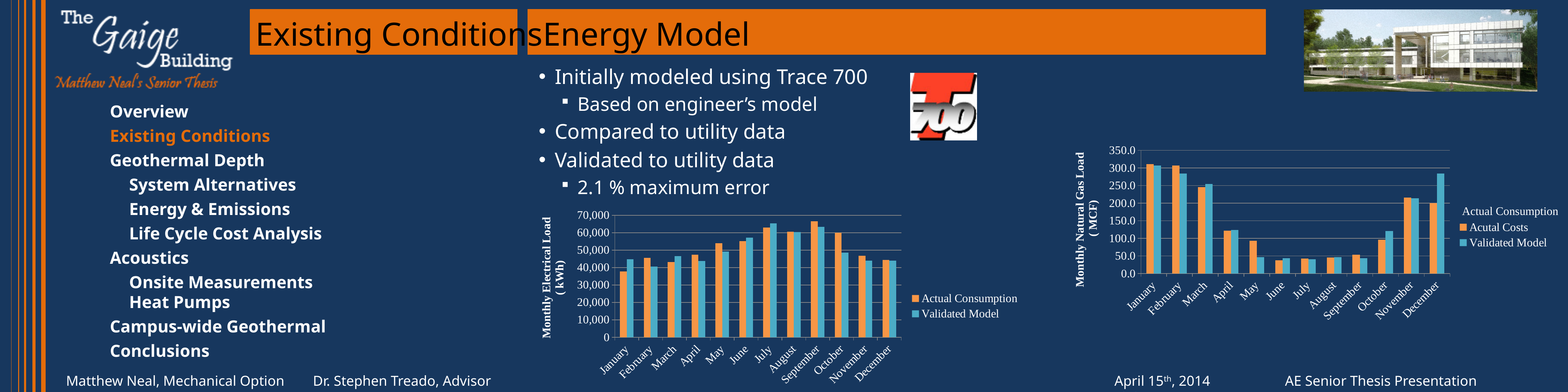
In the Monthly Natural Gas Load chart, is the Validated Model value for December greater or less than 250.0? greater In the Monthly Electrical Load chart, is the Actual Consumption for September greater or less than 60,000? greater In the Monthly Electrical Load chart, is the Actual Consumption for January greater or less than 40,000? less In the Monthly Electrical Load chart, how many months are shown on the x axis? 12 In the Monthly Natural Gas Load chart, which month has the highest Validated Model value? January In the Monthly Electrical Load chart, which month has the lowest Actual Consumption? January What kind of chart is the Monthly Electrical Load chart? bar chart In the Monthly Electrical Load chart, how many series does the legend list? 2 In the Monthly Natural Gas Load chart, which is larger for December: Acutal Costs or Validated Model? Validated Model In the Monthly Electrical Load chart, which is larger for January: Actual Consumption or Validated Model? Validated Model In the Monthly Electrical Load chart, which month has the highest Actual Consumption? September